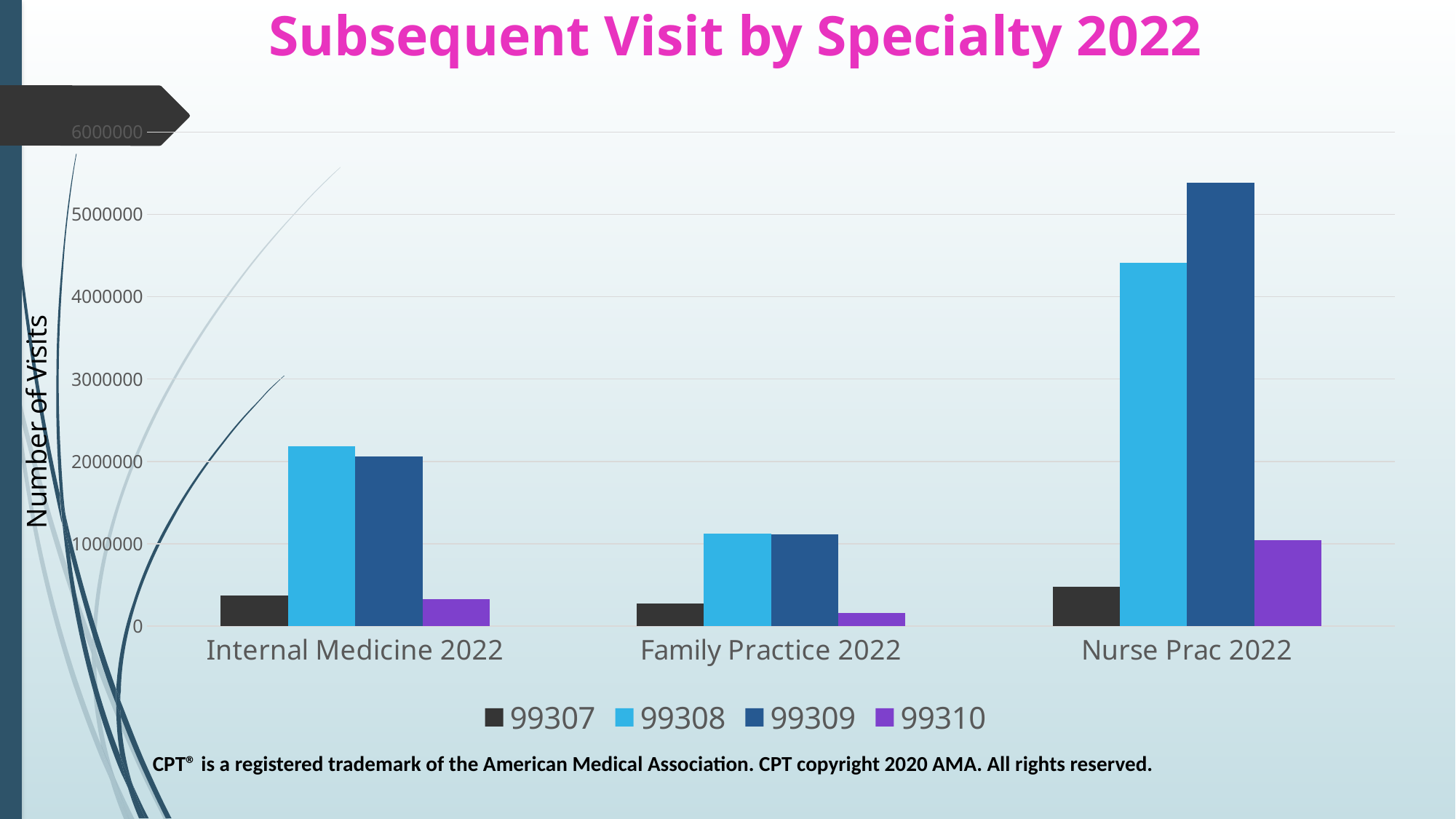
What is the title of the y axis? Number of Visits What is the title of the chart? Subsequent Visit by Specialty 2022 In Nurse Prac 2022, which is larger: 99308 or 99309? 99309 Which specialty has the lowest bar for 99310? Family Practice 2022 In Internal Medicine 2022, which is larger: 99308 or 99309? 99308 How many series does the legend list? 4 What kind of chart is shown on the slide? bar chart How many specialty categories are shown on the x axis? 3 Which specialty has the highest bar for 99309? Nurse Prac 2022 Is the value for 99308 in Internal Medicine 2022 greater or less than 2000000? greater Is the value for 99309 in Nurse Prac 2022 greater or less than 5000000? greater Is the value for 99307 in Nurse Prac 2022 greater or less than 1000000? less